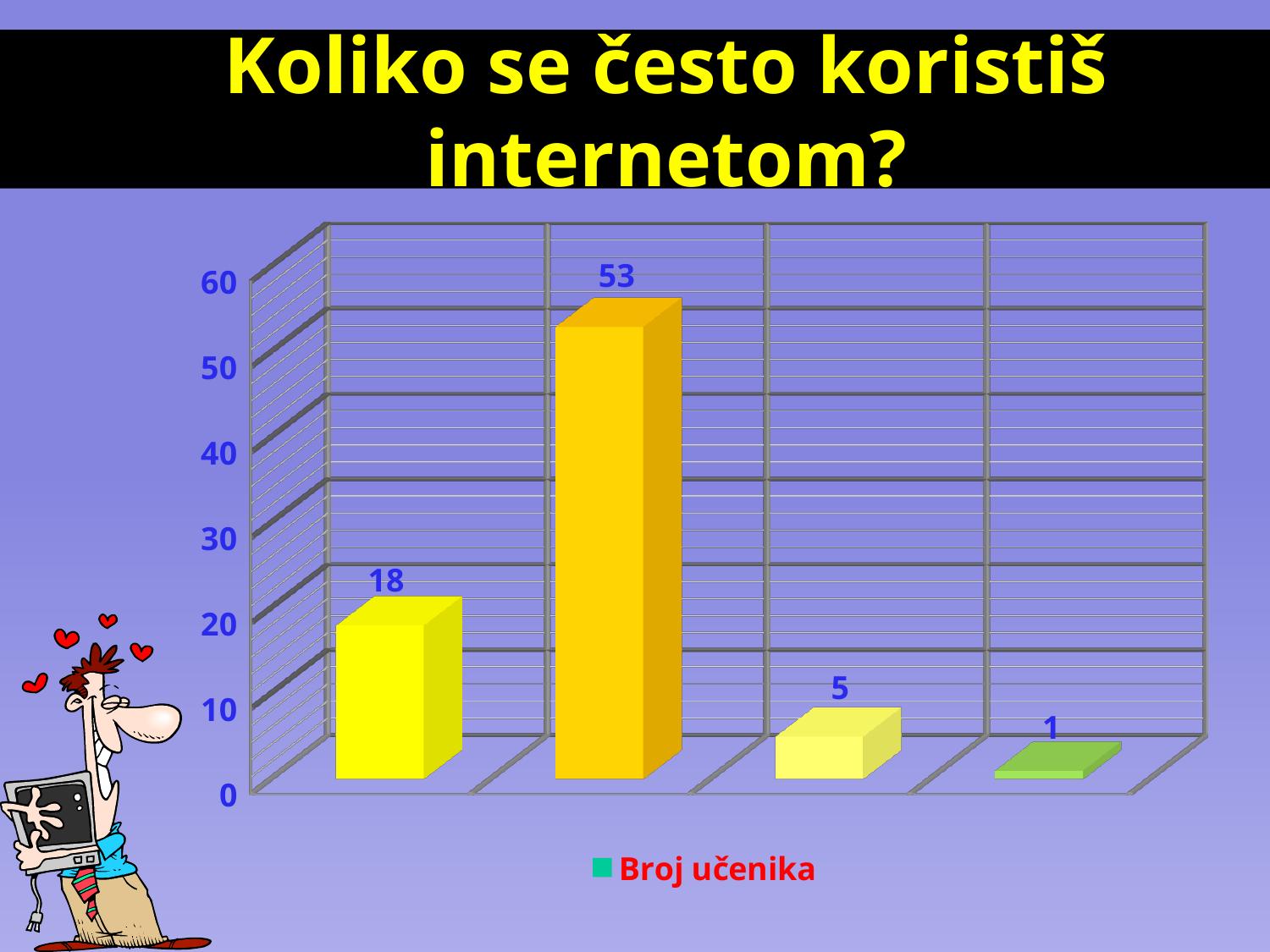
What is the value shown on the third bar from the left? 5 How many bars are plotted in the chart? 4 What is the series name shown in the legend? Broj učenika Which is larger, the value of the first bar or the value of the third bar? the first bar (18) What is the difference between the second bar (53) and the first bar (18)? 35 What is the value shown on the second bar from the left? 53 How many series does the legend list? 1 What is the value shown on the first bar from the left? 18 What is the highest value shown on any bar in the chart? 53 What kind of chart is shown on the slide? bar chart What is the lowest value shown on any bar in the chart? 1 What is the value shown on the fourth (rightmost) bar? 1